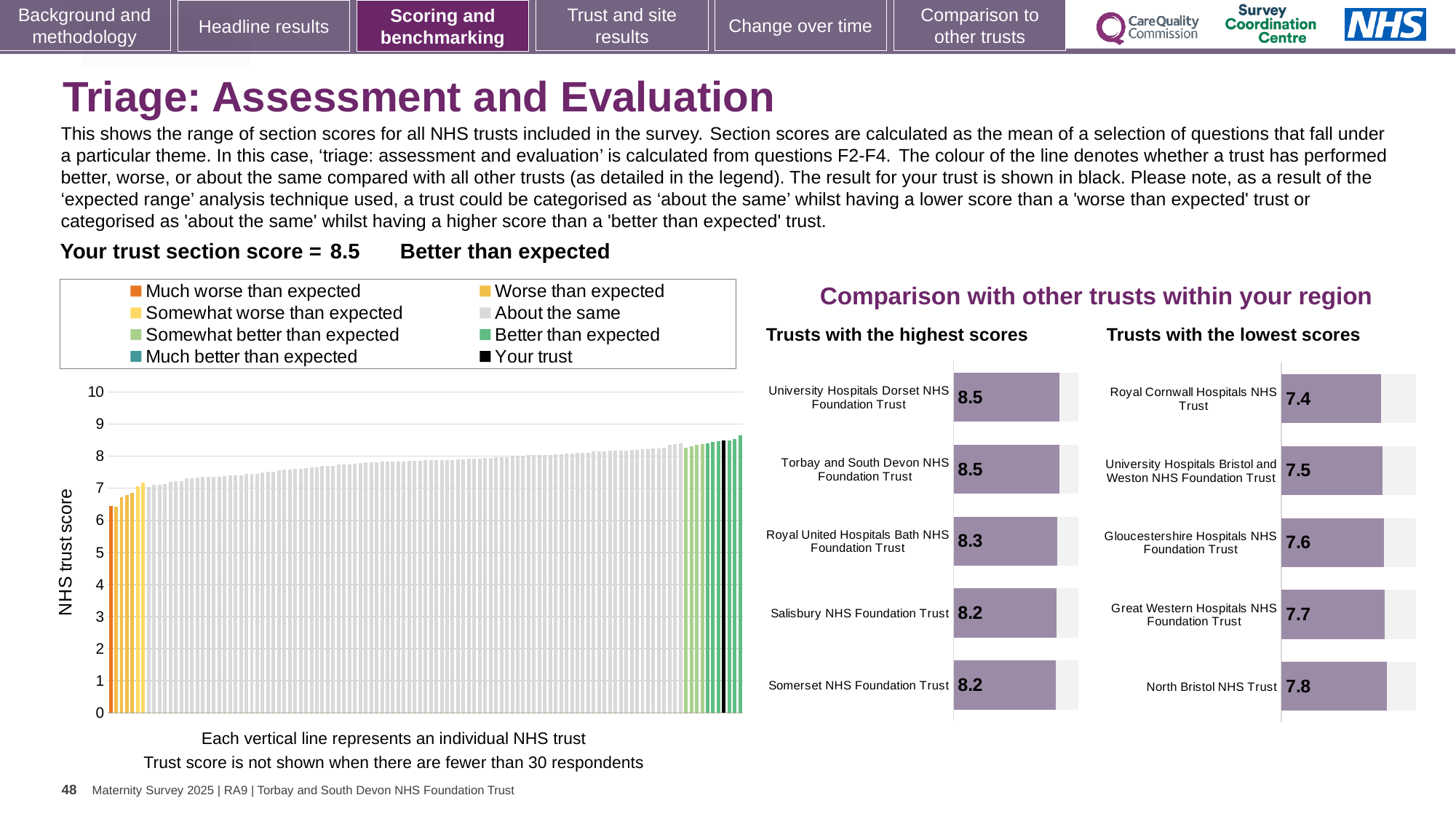
In the main 'NHS trust score' chart on the left, is the value for your trust (the black bar) greater or less than 8? greater What kind of chart is the 'Trusts with the lowest scores' chart? Bar chart In the 'Trusts with the highest scores' chart, what is the difference between the score for University Hospitals Dorset NHS Foundation Trust and the score for Somerset NHS Foundation Trust? 0.3 In the 'Trusts with the lowest scores' chart, do the scores increase or decrease going down the list from Royal Cornwall Hospitals NHS Trust to North Bristol NHS Trust? Increase How many entries does the legend of the main 'NHS trust score' chart on the left list? 8 In the 'Trusts with the lowest scores' chart, which trust has the lowest score? Royal Cornwall Hospitals NHS Trust In the 'Trusts with the lowest scores' chart, what is the difference between the score for North Bristol NHS Trust and the score for Royal Cornwall Hospitals NHS Trust? 0.4 How many trusts are shown in the 'Trusts with the highest scores' chart? 5 In the 'Trusts with the lowest scores' chart, what is the score for Gloucestershire Hospitals NHS Foundation Trust? 7.6 In the 'Trusts with the lowest scores' chart, which has the higher score: Great Western Hospitals NHS Foundation Trust or North Bristol NHS Trust? North Bristol NHS Trust In the 'Trusts with the highest scores' chart, what is the score for Royal United Hospitals Bath NHS Foundation Trust? 8.3 In the 'Trusts with the highest scores' chart, what is the score for Salisbury NHS Foundation Trust? 8.2